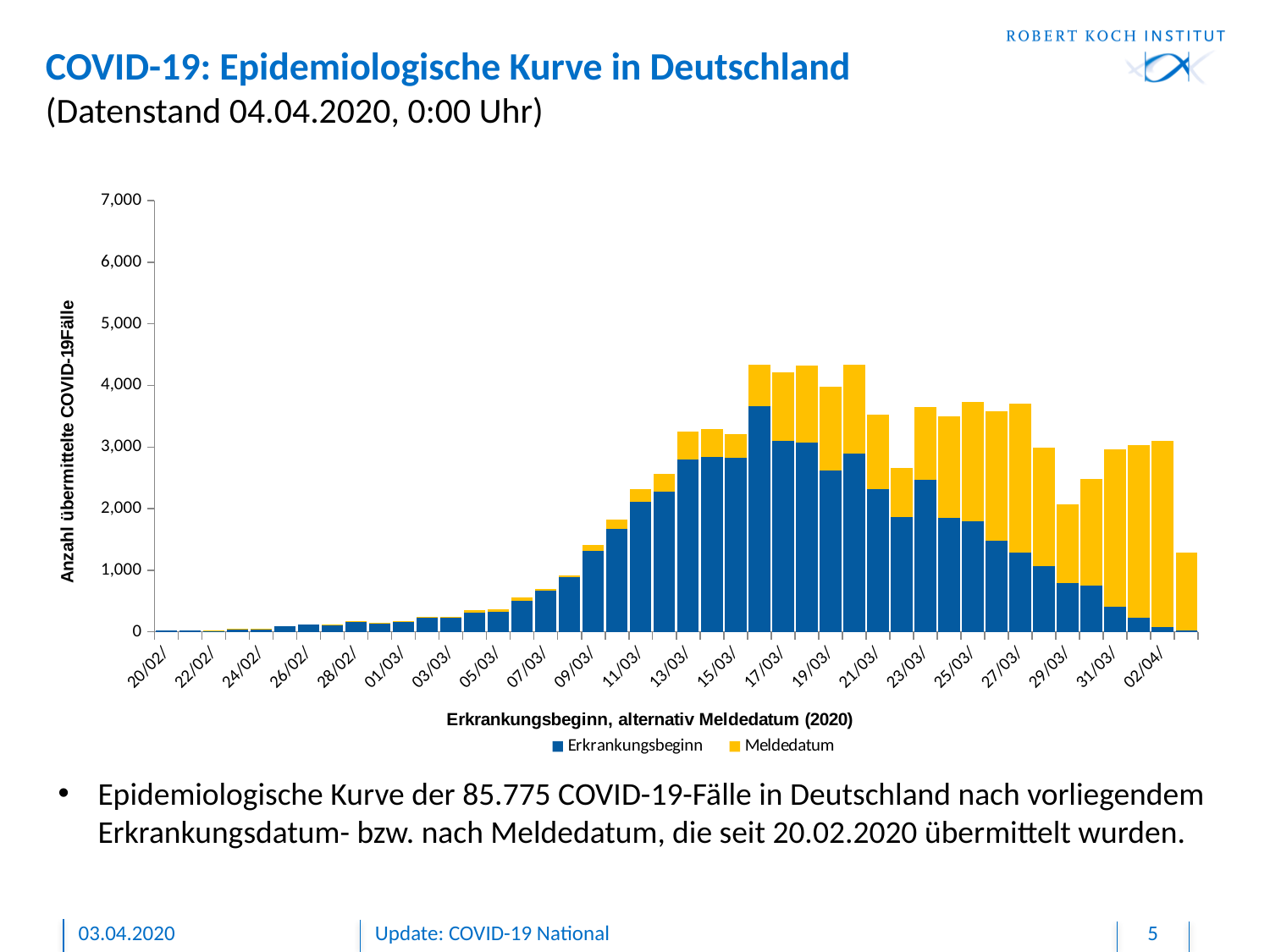
Is the total height of the bar for 02/04 greater or less than 2,000? greater Is the total height of the bar for 29/03 greater or less than 3,000? less Do the total bar heights rise or fall from 20/02 to 17/03? rise How many series does the legend list? 2 What kind of chart is shown on the slide? stacked bar chart Is the total height of the bar for 13/03 greater or less than 3,000? greater How many date labels are shown on the x axis? 22 What are the two series named in the legend? Erkrankungsbeginn and Meldedatum Which colour represents the Meldedatum series? yellow